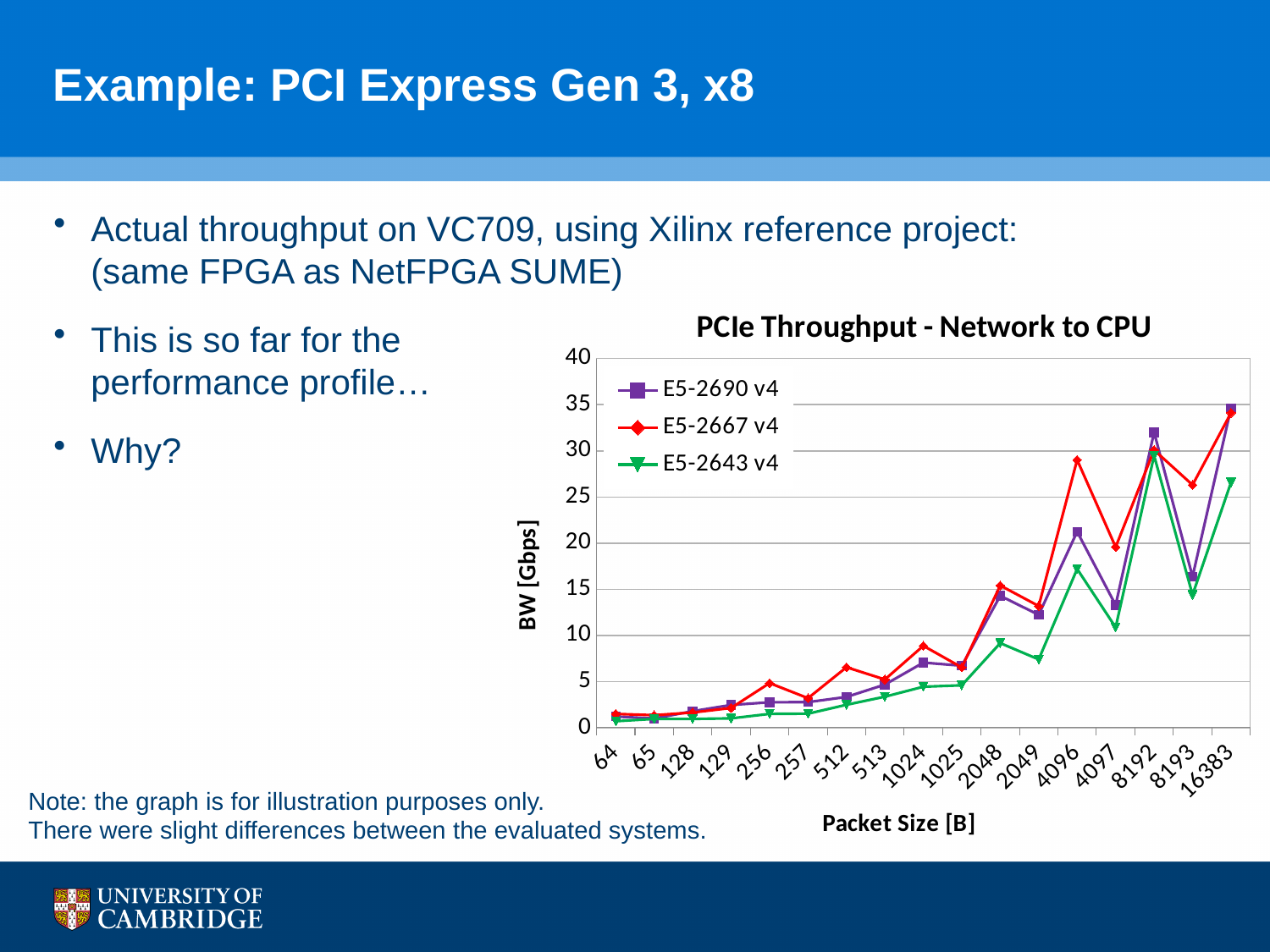
What kind of chart is shown on the slide? Line chart How many series does the chart legend list? 3 At packet size 8193, which series has the higher value, E5-2667 v4 or E5-2690 v4? E5-2667 v4 What is the title of the chart? PCIe Throughput - Network to CPU How many packet sizes are plotted along the x axis? 17 What is the label of the y axis? BW [Gbps] Is the value for E5-2643 v4 at packet size 8193 greater or less than 20? less Overall, do the throughput values rise or fall as packet size increases along the x axis? rise Is the value for E5-2643 v4 at packet size 4097 greater or less than 15? less Is the value for E5-2667 v4 at packet size 4096 greater or less than 25? greater At which packet size does the E5-2643 v4 series reach its highest value? 8192